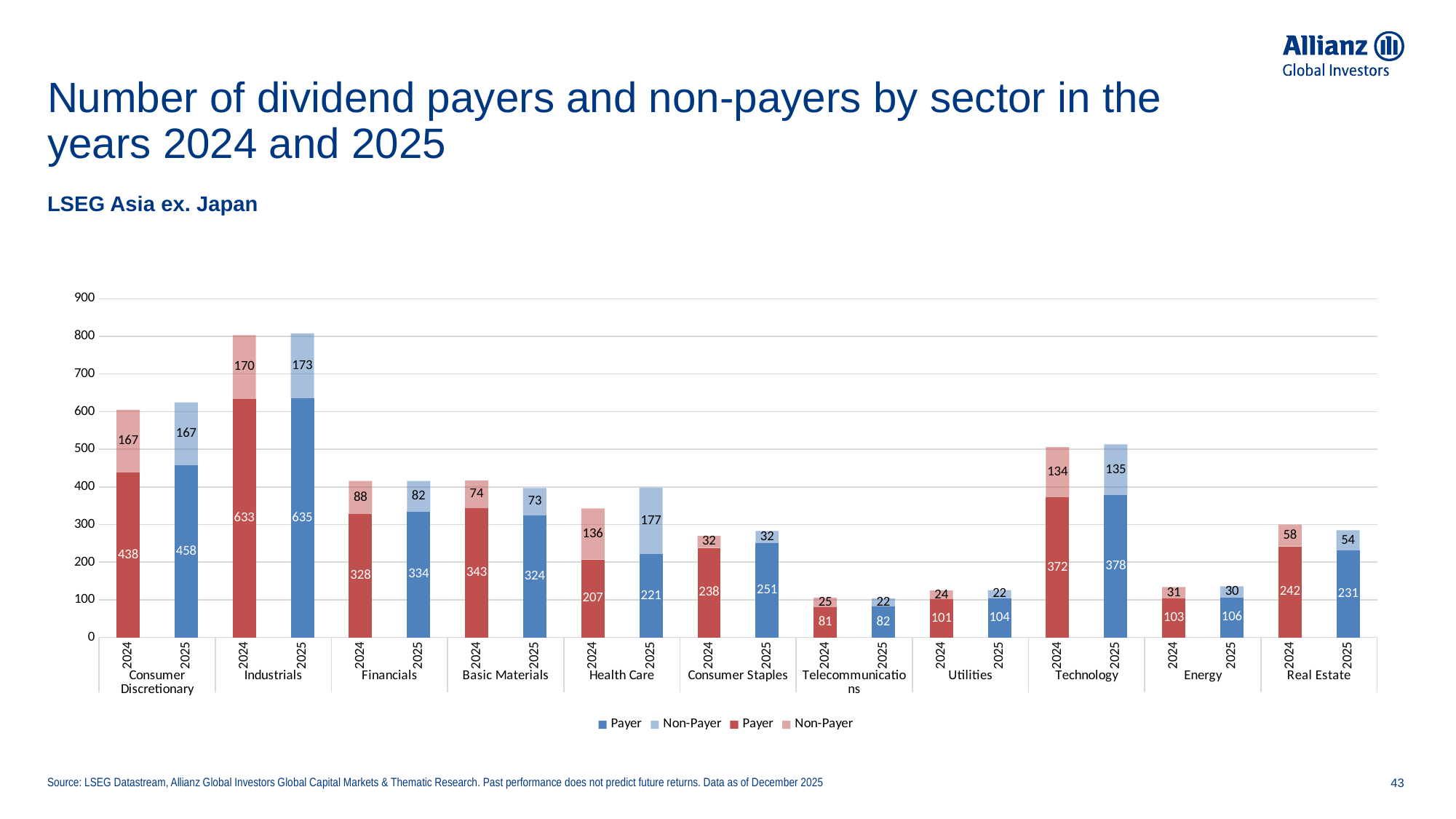
Which sector has the highest number of dividend payers in 2025? Industrials What kind of chart is shown on the slide? Stacked bar chart How many sectors are shown on the x axis of the chart? 11 Which is larger: the number of payers in Basic Materials in 2024 or in 2025? 2024 What is the total number of payers and non-payers in Industrials in 2025? 808 How many dividend payers did the Industrials sector have in 2025? 635 Which sector has the lowest number of dividend payers in 2024? Telecommunications How many dividend payers were there in Technology in 2024? 372 How many entries does the chart legend list? 4 What is the difference between the number of payers in Consumer Discretionary in 2025 and in 2024? 20 What is the number of non-payers in Health Care in 2025? 177 What is the total number of payers and non-payers in Consumer Discretionary in 2024? 605